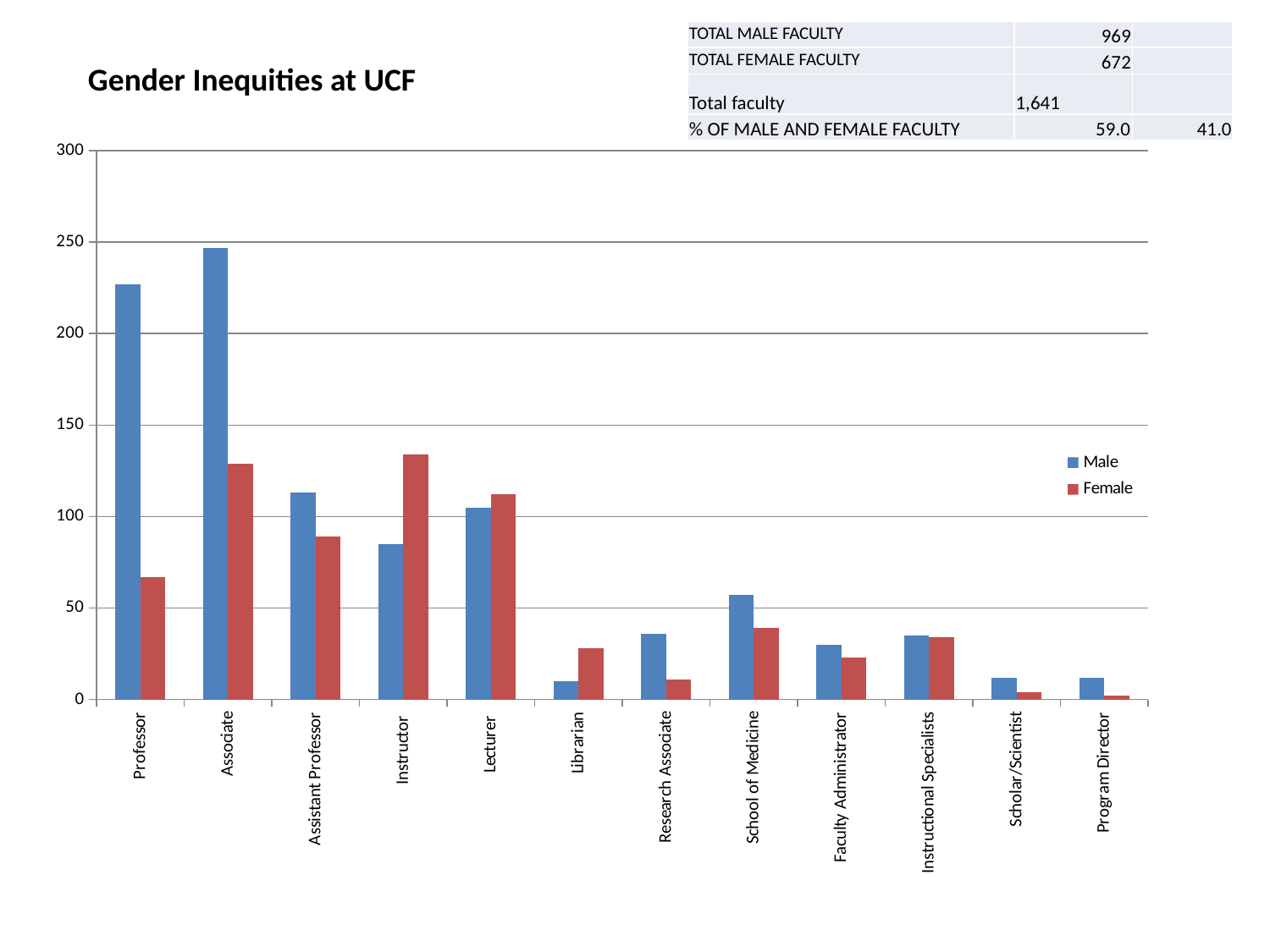
What kind of chart is shown on the slide? bar chart For Professor, which is larger, the Male value or the Female value? Male How many series does the chart legend list? 2 Is the Female value for Instructor greater or less than 100? greater For Instructor, which is larger, the Male value or the Female value? Female Is the Male value for Librarian greater or less than 50? less Is the Male value for Professor greater or less than 200? greater Which category has the highest Male value? Associate How many job categories are shown on the x axis of the chart? 12 What is the title of the slide containing the chart? Gender Inequities at UCF Which colour represents the Female series in the chart? red